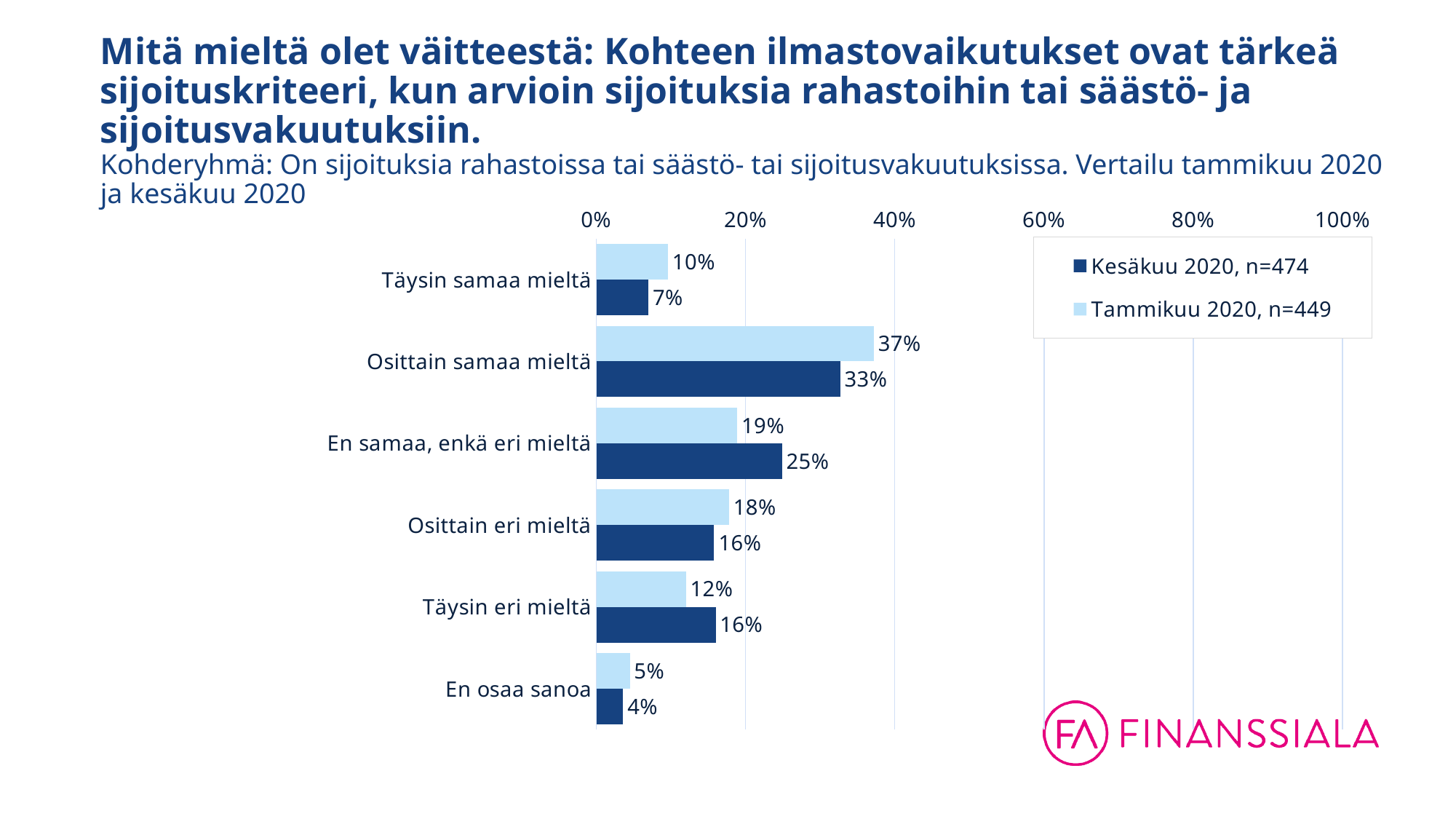
How many categories are shown on the chart? 6 Which series is shown in dark blue according to the legend? Kesäkuu 2020, n=474 What is the value for "Osittain samaa mieltä" in the Kesäkuu 2020, n=474 series? 33% What is the difference between the Tammikuu 2020 and Kesäkuu 2020 values for "En samaa, enkä eri mieltä"? 6% Which category has the highest value in the Tammikuu 2020, n=449 series? Osittain samaa mieltä For "Täysin samaa mieltä", which series has the larger value, Kesäkuu 2020 or Tammikuu 2020? Tammikuu 2020 Is the value for "Osittain samaa mieltä" in the Tammikuu 2020 series greater or less than 20%? greater Which category has the lowest value in the Kesäkuu 2020, n=474 series? En osaa sanoa What is the value for "En samaa, enkä eri mieltä" in the Tammikuu 2020, n=449 series? 19% What is the value for "Täysin eri mieltä" in the Kesäkuu 2020, n=474 series? 16% What kind of chart is shown on the slide? Bar chart How many series does the legend list? 2